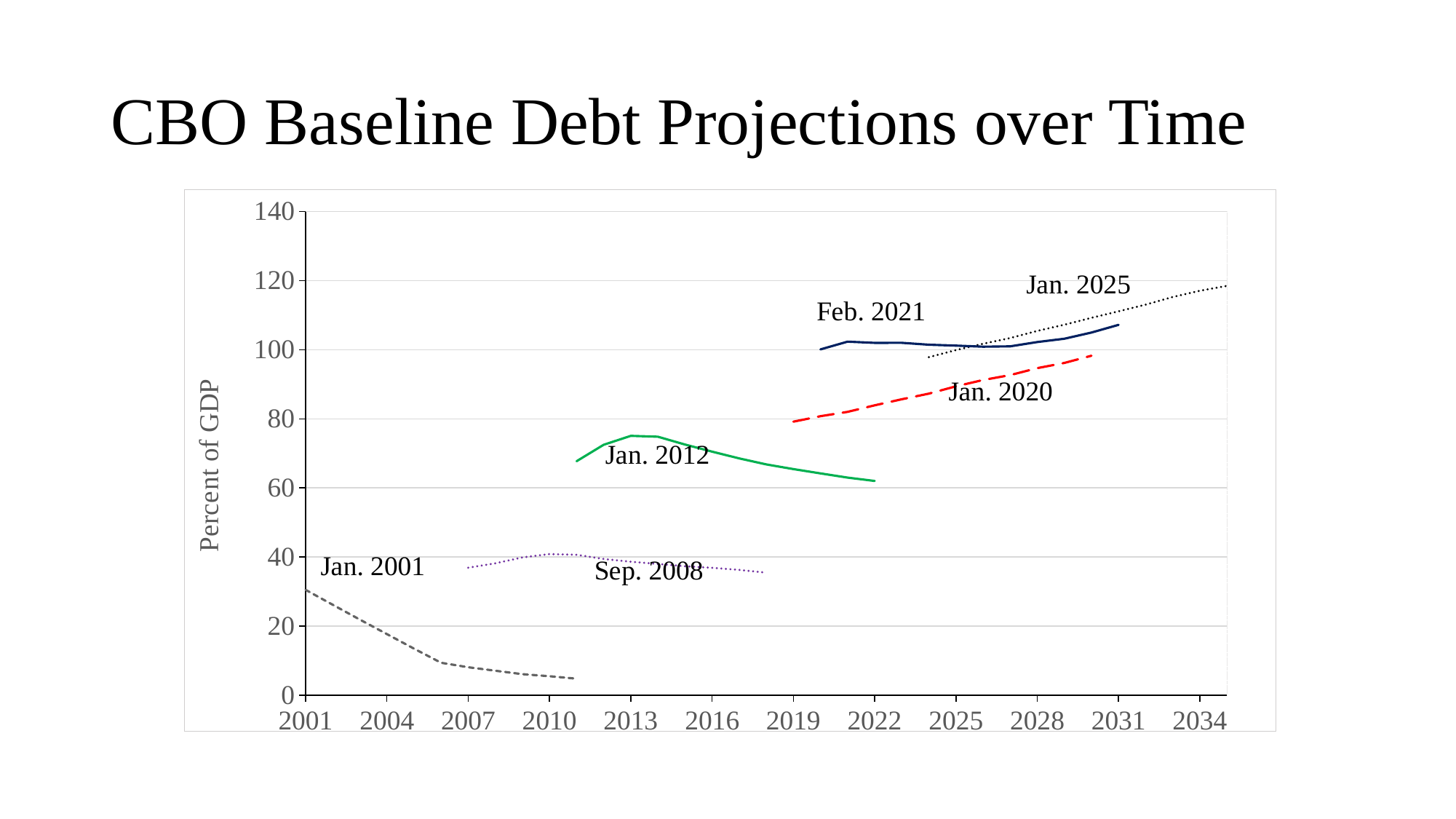
Does the Jan. 2020 projection line rise or fall over its years? rise How many labeled projection lines are plotted on the chart? 6 Is the value of the Jan. 2001 projection at its starting year 2001 greater or less than 20? greater What is the title of the chart on the slide? CBO Baseline Debt Projections over Time Which projection line reaches the lowest value on the chart? Jan. 2001 Which projection line reaches the highest value on the chart? Jan. 2025 Does the Jan. 2001 projection line rise or fall over its years? fall What kind of chart is shown on the slide? line chart Is the value of the Feb. 2021 projection in 2031 greater or less than 80? greater In 2025, which projection shows a higher value: Feb. 2021 or Jan. 2020? Feb. 2021 What is the label on the vertical axis? Percent of GDP Is the peak value of the Jan. 2012 projection greater or less than 80? less